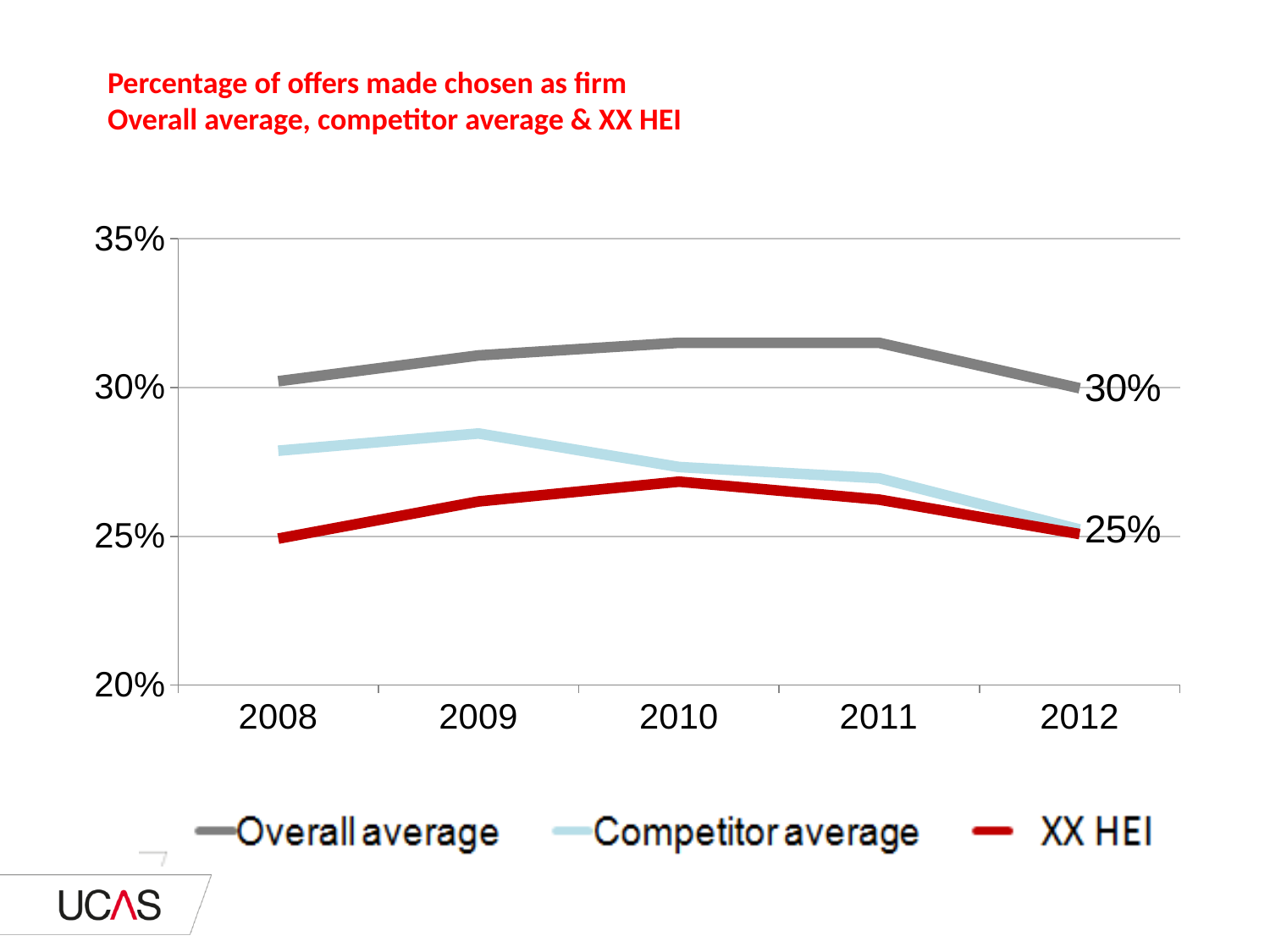
How many years are shown on the x axis? 5 What is the Overall average value in 2012? 30% Which series has the lowest value in 2008? XX HEI In 2008, which is larger: Overall average or Competitor average? Overall average How many series does the legend list? 3 What kind of chart is shown on the slide? line chart Which series has the highest value in 2010? Overall average What is the XX HEI value in 2012? 25% In which year does XX HEI reach its highest value? 2010 Is the Competitor average value in 2009 greater or less than 30%? less Is the Overall average value in 2010 greater or less than 30%? greater Does the XX HEI line rise or fall between 2010 and 2012? fall